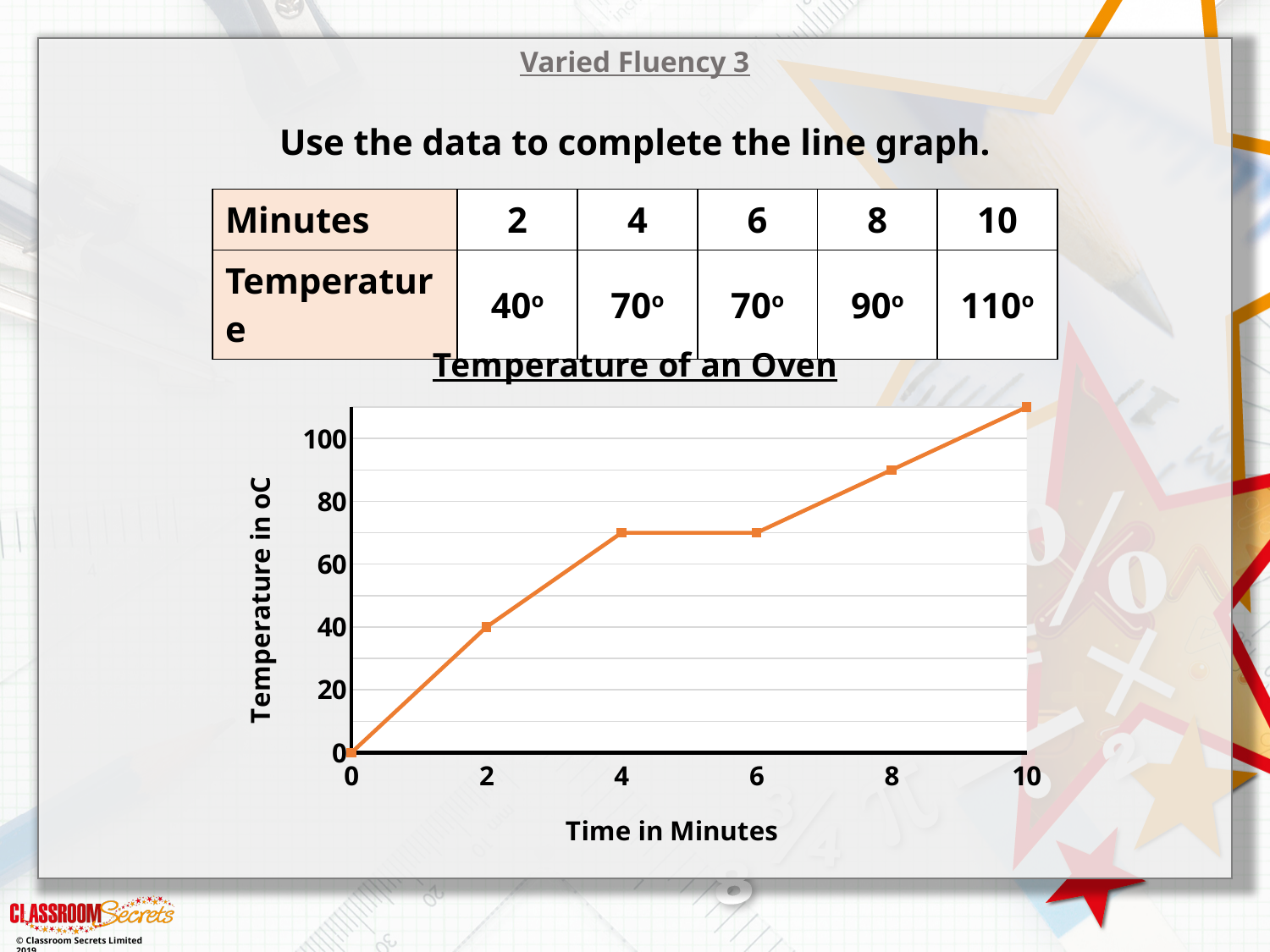
What is the title of the chart? Temperature of an Oven What is the difference in temperature between 10 minutes and 2 minutes? 70° What is the label of the x axis? Time in Minutes Does the temperature generally rise or fall as time in minutes increases? rise At which time in minutes is the temperature highest? 10 What is the temperature at 2 minutes? 40° Is the temperature at 8 minutes greater or less than 80? greater What is the temperature at 10 minutes? 110° At which time in minutes is the temperature lowest? 0 Is the temperature at 4 minutes greater or less than 60? greater What type of chart is shown on the slide? line chart What is the temperature at 8 minutes? 90°